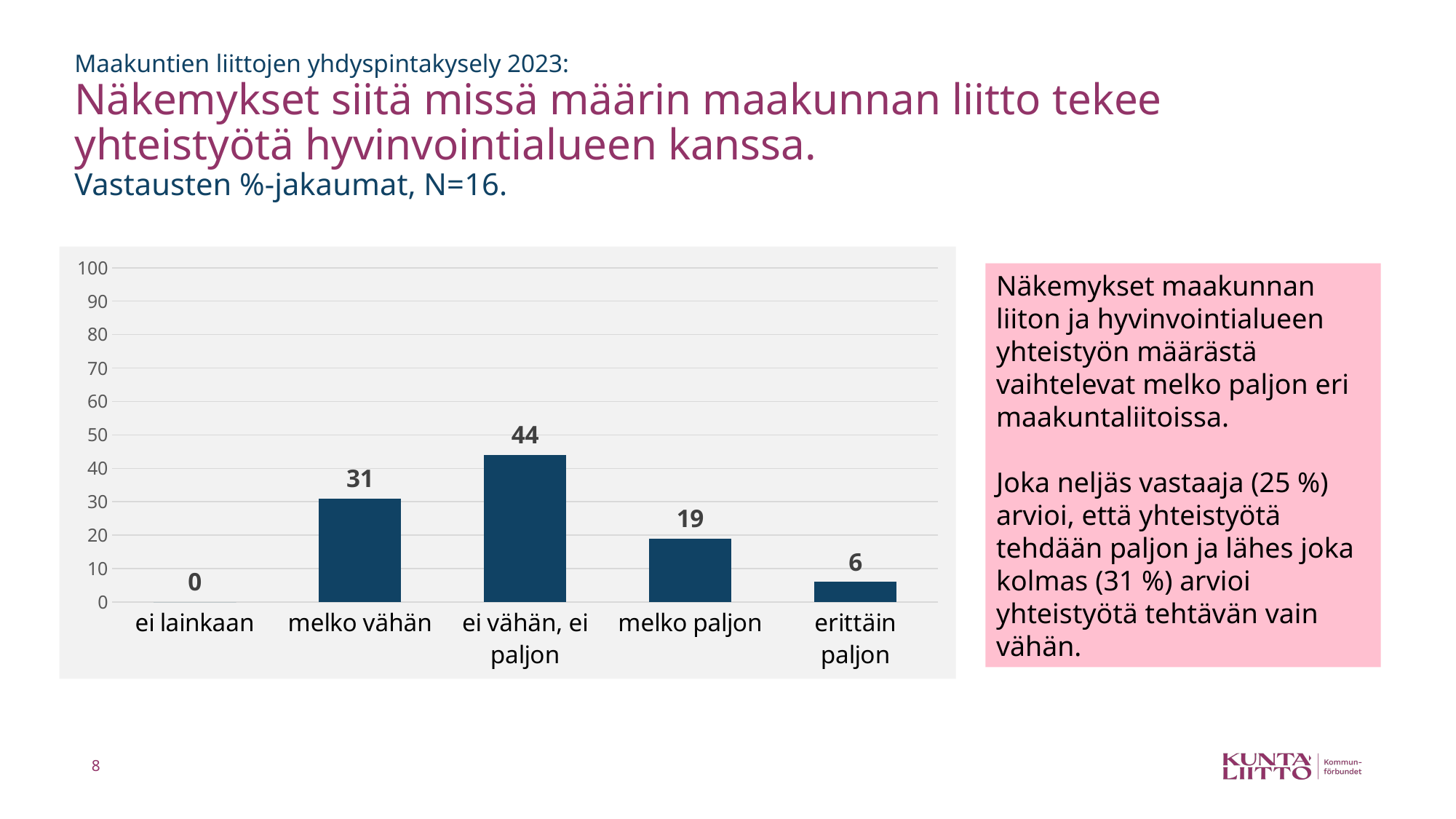
Is the value for "melko paljon" greater or less than 20? less What is the value for "melko vähän"? 31 Which category has the highest value? ei vähän, ei paljon How many categories are shown on the x axis? 5 Which category has the lowest value? ei lainkaan Which is larger, the value for "melko vähän" or the value for "melko paljon"? melko vähän What kind of chart is shown on the slide? bar chart What is the value for "ei lainkaan"? 0 What is the value for "erittäin paljon"? 6 What is the maximum value shown on the y axis? 100 What is the difference between the values for "ei vähän, ei paljon" and "melko paljon"? 25 What is the value for "ei vähän, ei paljon"? 44